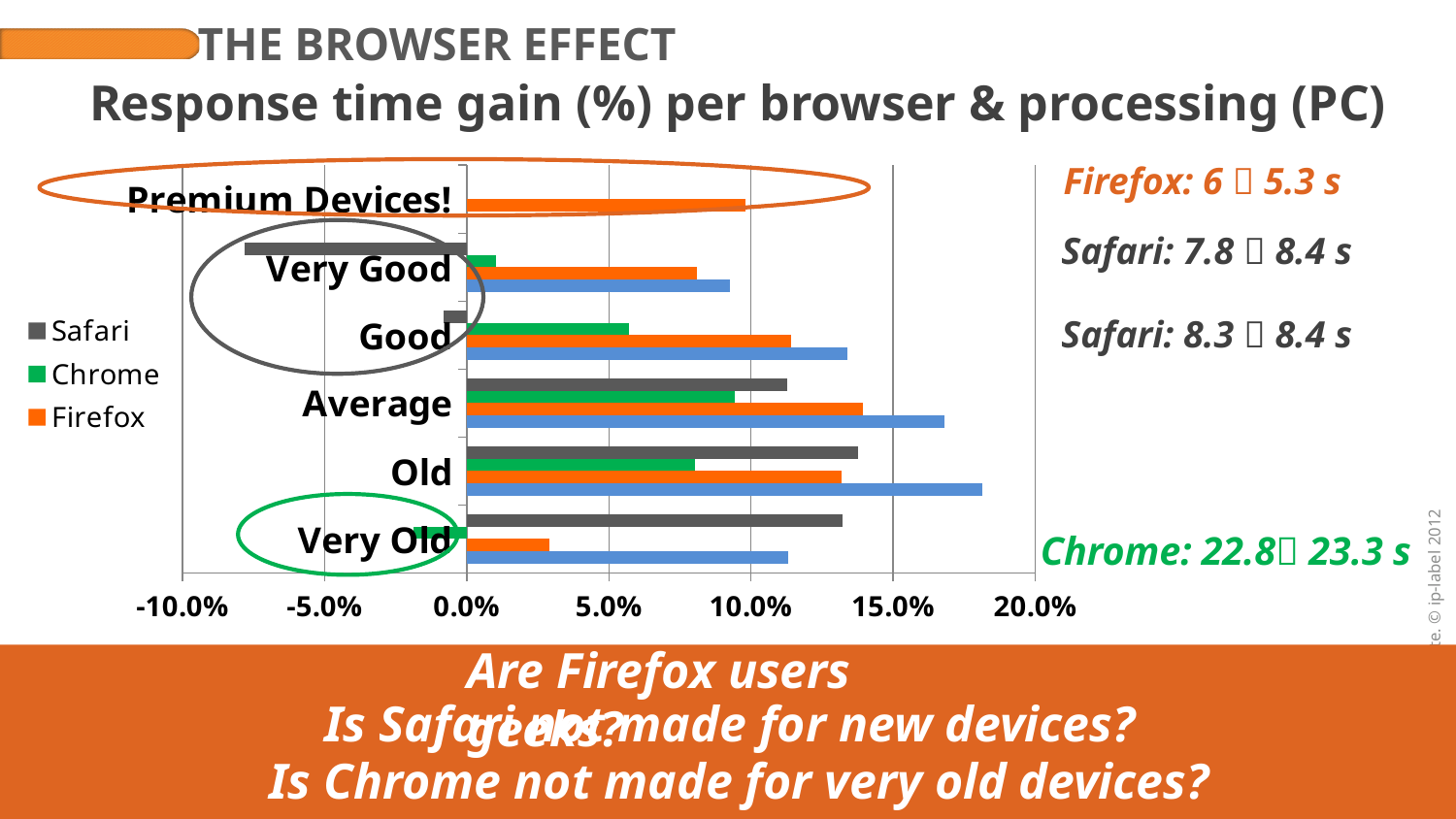
What kind of chart is shown on the slide? bar chart Is the Safari value for Old greater or less than 10.0%? greater What is the title of the chart? Response time gain (%) per browser & processing (PC) Which category has the lowest Chrome value? Very Old How many device categories are shown on the chart's vertical axis? 6 How many series does the chart legend list? 3 Is the Chrome value for Very Old greater or less than 0.0%? less Is the Safari value for Very Good greater or less than 0.0%? less Which is larger, the Firefox value for Average or the Firefox value for Very Old? Average Which colour represents Firefox in the legend? orange